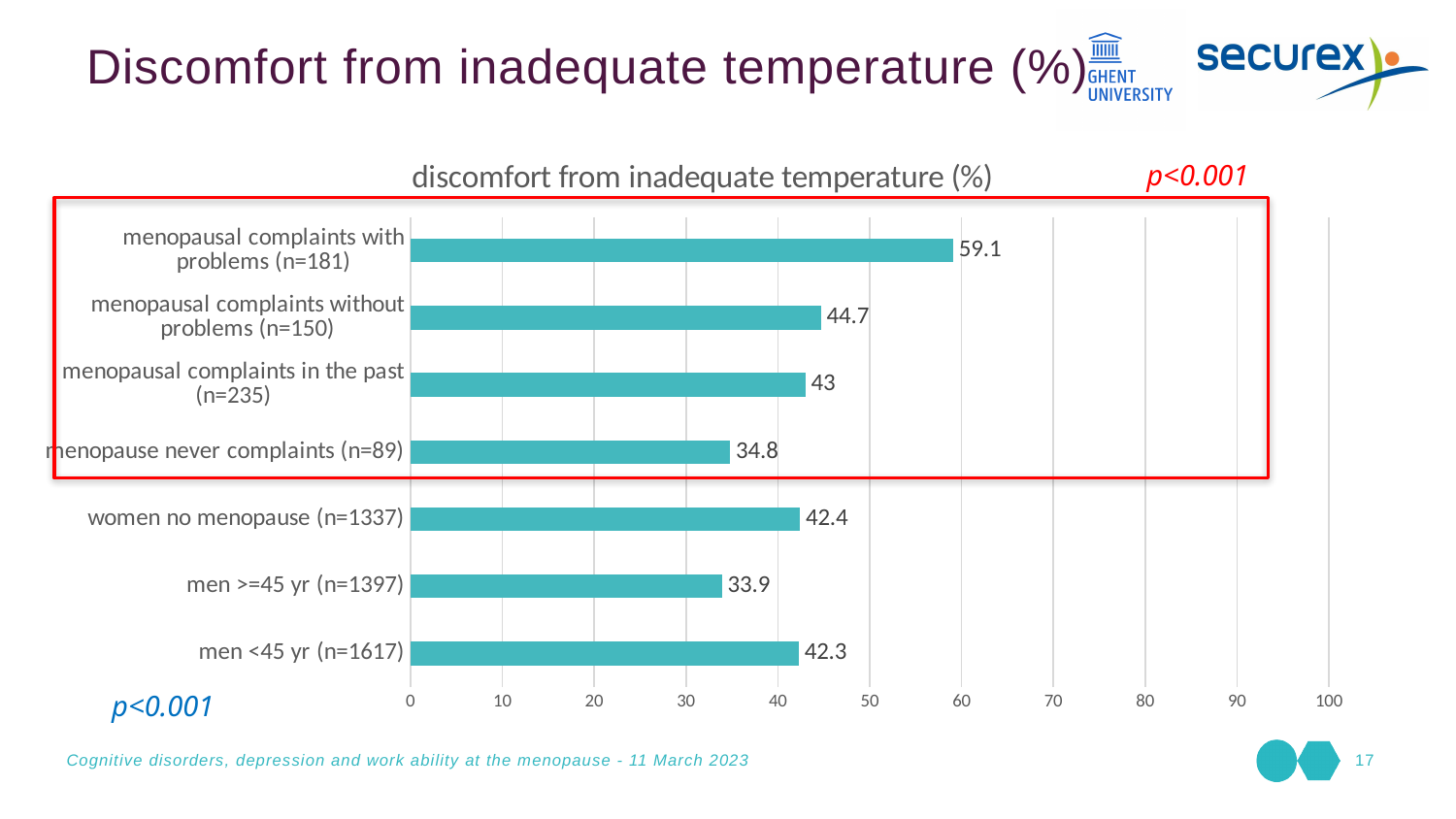
What is the difference between the values for menopausal complaints with problems (n=181) and menopausal complaints without problems (n=150)? 14.4 Which category has the lowest value? men >=45 yr (n=1397) What kind of chart is shown on the slide? bar chart What is the difference between the values for men <45 yr (n=1617) and men >=45 yr (n=1397)? 8.4 What is the value for menopausal complaints with problems (n=181)? 59.1 Which is larger: the value for menopausal complaints in the past (n=235) or the value for menopause never complaints (n=89)? menopausal complaints in the past (n=235) What is the title of the chart? discomfort from inadequate temperature (%) What is the value for women no menopause (n=1337)? 42.4 Is the value for menopausal complaints with problems (n=181) greater or less than 50? greater What is the value for men >=45 yr (n=1397)? 33.9 How many categories are shown in the chart? 7 Which category has the highest value? menopausal complaints with problems (n=181)